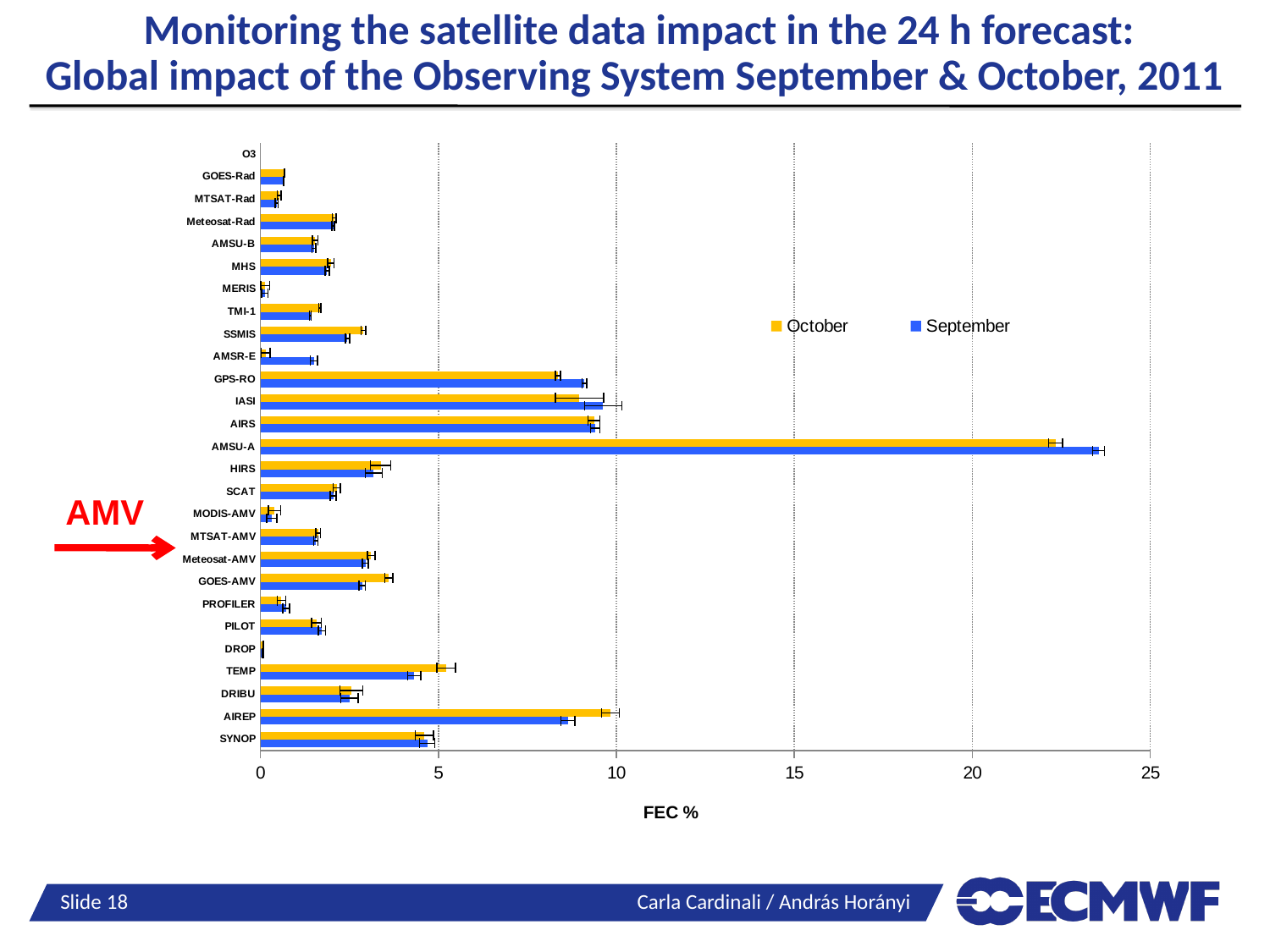
Which category has the highest FEC % value? AMSU-A Is the October value for AIREP greater or less than 5? greater Is the October value for HIRS greater or less than 5? less Is the October value for GPS-RO greater or less than 10? less How many categories are plotted on the y axis? 27 What is the label of the x axis? FEC % What kind of chart is shown on the slide? bar chart How many series does the legend list? 2 For AIREP, which series has the larger value, October or September? October For AMSR-E, which series has the larger value, October or September? September For AMSU-A, which series has the larger value, October or September? September